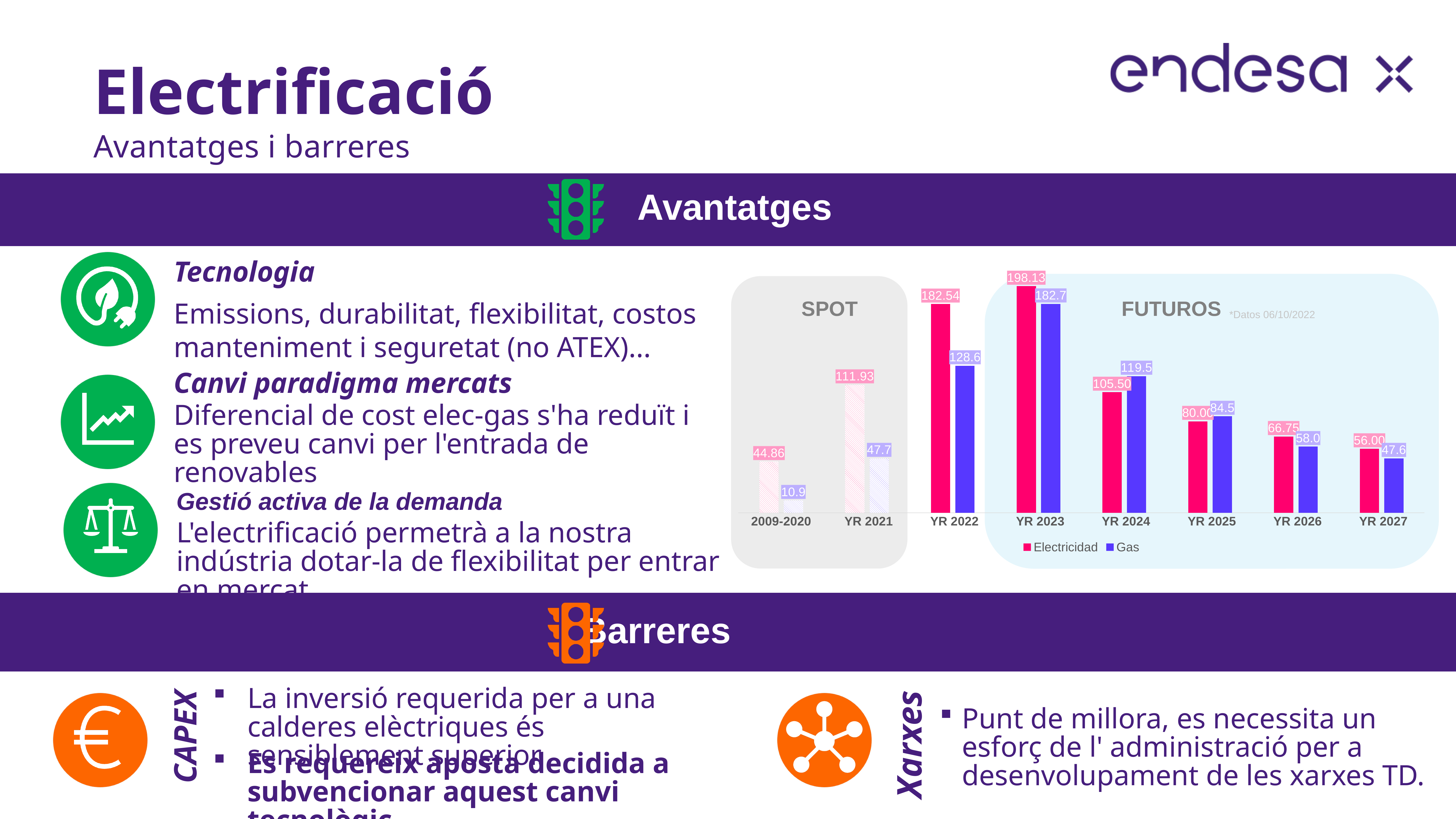
How many series does the chart legend list? 2 What kind of chart is shown on the slide? Bar chart Which category has the lowest Gas value? 2009-2020 What is the Gas value for YR 2027? 47.6 How many categories are shown on the x axis of the chart? 8 What is the difference between the Electricidad and Gas values for YR 2021? 64.23 What is the Electricidad value for 2009-2020? 44.86 For YR 2024, which is larger, the Electricidad value or the Gas value? Gas What is the Electricidad value for YR 2023? 198.13 What is the Gas value for YR 2022? 128.6 Which category has the highest Electricidad value? YR 2023 Do the Electricidad values rise or fall from YR 2023 to YR 2027? Fall